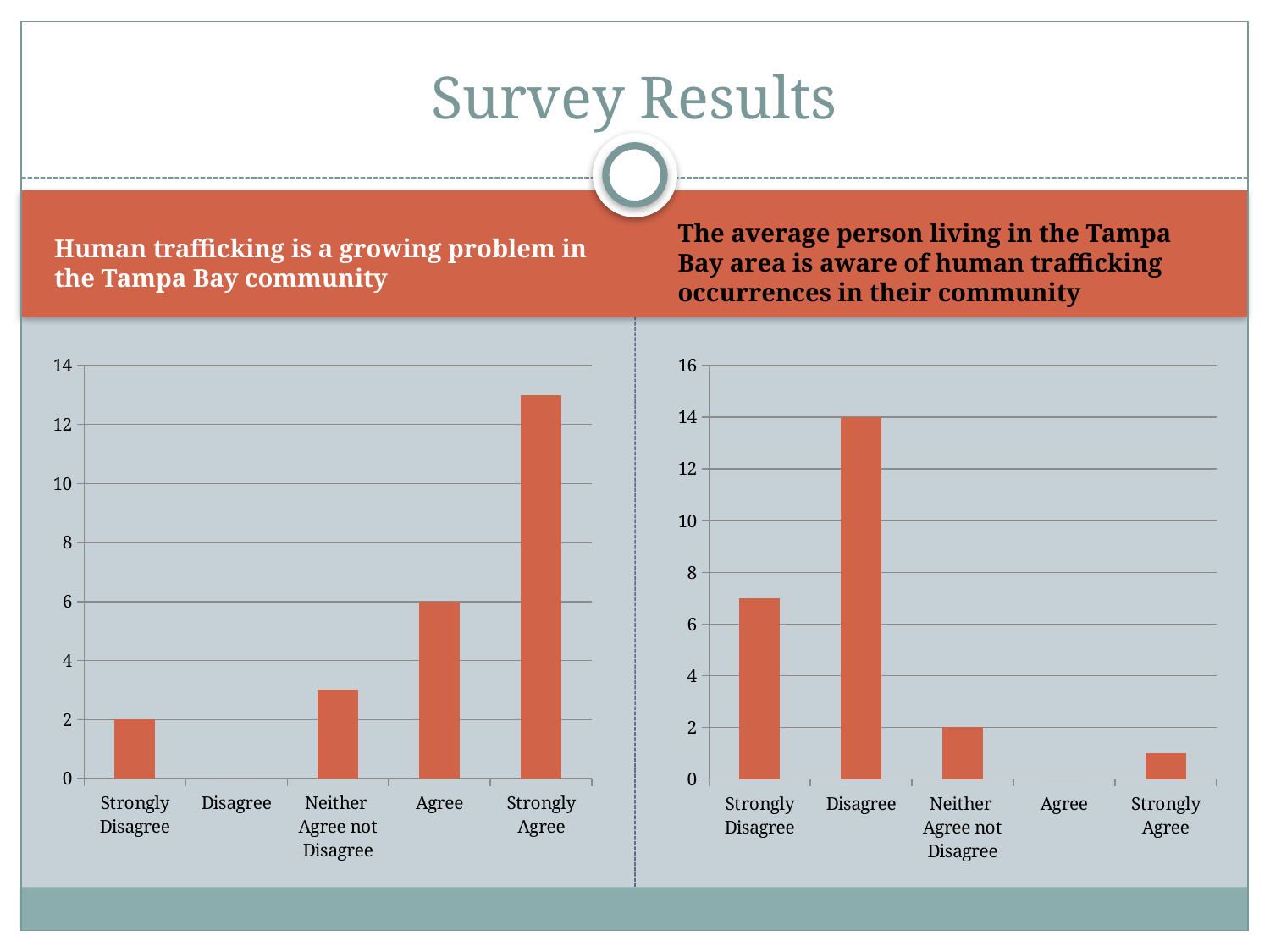
On the left chart, 'Human trafficking is a growing problem in the Tampa Bay community', what is the value for Strongly Disagree? 2 On the left chart, 'Human trafficking is a growing problem in the Tampa Bay community', which category has the highest value? Strongly Agree How many categories are shown on the x axis of the left chart, 'Human trafficking is a growing problem in the Tampa Bay community'? 5 On the right chart, 'The average person living in the Tampa Bay area is aware of human trafficking occurrences in their community', what is the value for Neither Agree not Disagree? 2 On the right chart, 'The average person living in the Tampa Bay area is aware of human trafficking occurrences in their community', which category has the highest value? Disagree On the left chart, 'Human trafficking is a growing problem in the Tampa Bay community', is the value for Strongly Agree greater or less than 12? greater On the left chart, 'Human trafficking is a growing problem in the Tampa Bay community', what is the value for Agree? 6 On the right chart, 'The average person living in the Tampa Bay area is aware of human trafficking occurrences in their community', which is larger, the value for Strongly Disagree or the value for Strongly Agree? Strongly Disagree On the right chart, 'The average person living in the Tampa Bay area is aware of human trafficking occurrences in their community', what is the value for Disagree? 14 On the left chart, 'Human trafficking is a growing problem in the Tampa Bay community', which category has the lowest value? Disagree On the right chart, 'The average person living in the Tampa Bay area is aware of human trafficking occurrences in their community', is the value for Strongly Disagree greater or less than 6? greater On the left chart, 'Human trafficking is a growing problem in the Tampa Bay community', what is the difference between the values for Agree and Strongly Disagree? 4